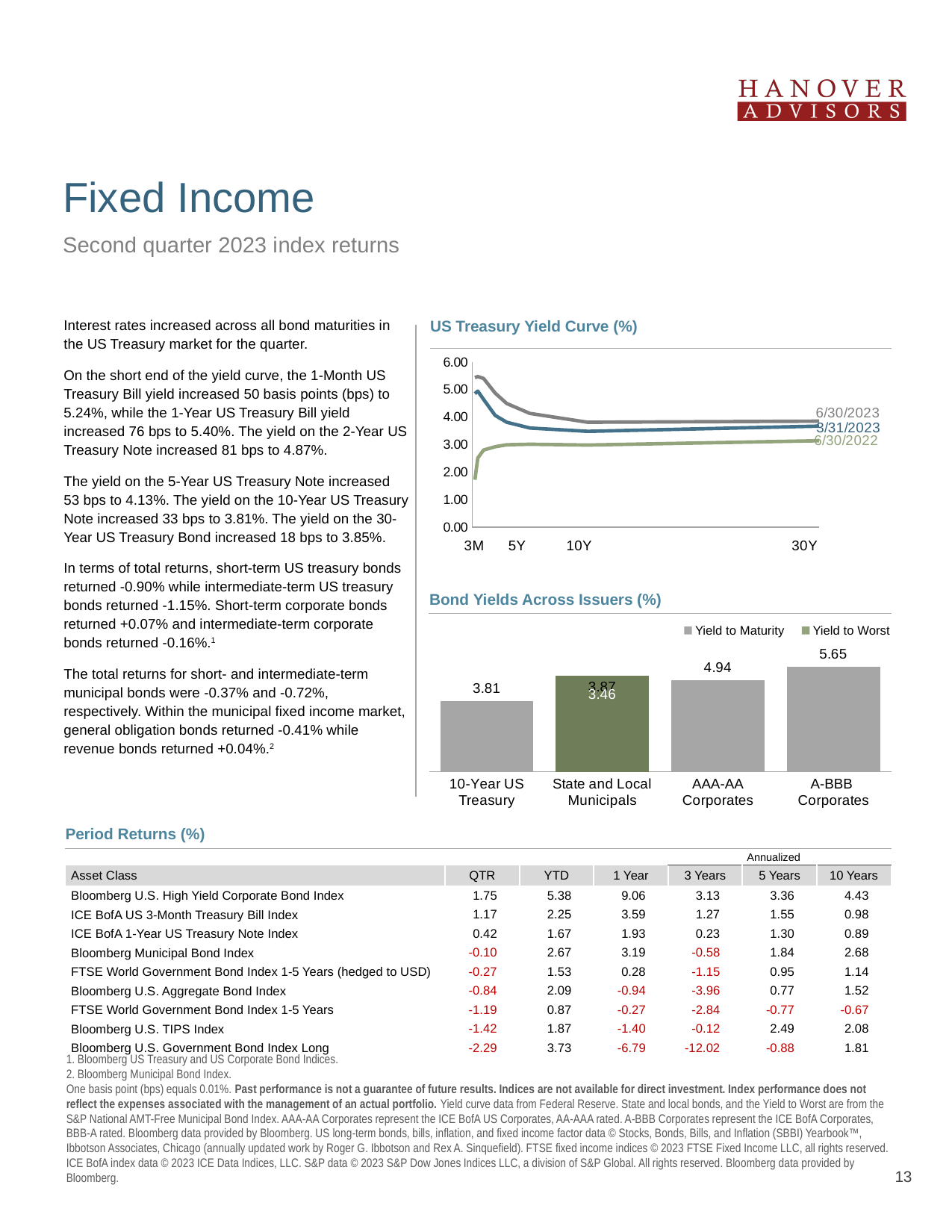
How many categories are shown on the x axis of the 'Bond Yields Across Issuers (%)' chart? 4 In the 'US Treasury Yield Curve (%)' chart, does the 6/30/2023 line generally rise or fall from 3M to 30Y? fall In the 'Bond Yields Across Issuers (%)' chart, which is larger: AAA-AA Corporates or 10-Year US Treasury? AAA-AA Corporates In the 'US Treasury Yield Curve (%)' chart, is the 6/30/2023 value at 3M greater or less than 5.00? greater In the 'Bond Yields Across Issuers (%)' chart, which category has the highest value? A-BBB Corporates In the 'Bond Yields Across Issuers (%)' chart, what is the value for 10-Year US Treasury? 3.81 How many series does the legend of the 'US Treasury Yield Curve (%)' chart list? 3 In the 'Bond Yields Across Issuers (%)' chart, what is the value for AAA-AA Corporates? 4.94 How many series does the legend of the 'Bond Yields Across Issuers (%)' chart list? 2 In the 'Bond Yields Across Issuers (%)' chart, what is the difference between the values for A-BBB Corporates and AAA-AA Corporates? 0.71 In the 'Bond Yields Across Issuers (%)' chart, what is the value for A-BBB Corporates? 5.65 What kind of chart is the 'Bond Yields Across Issuers (%)' chart? bar chart